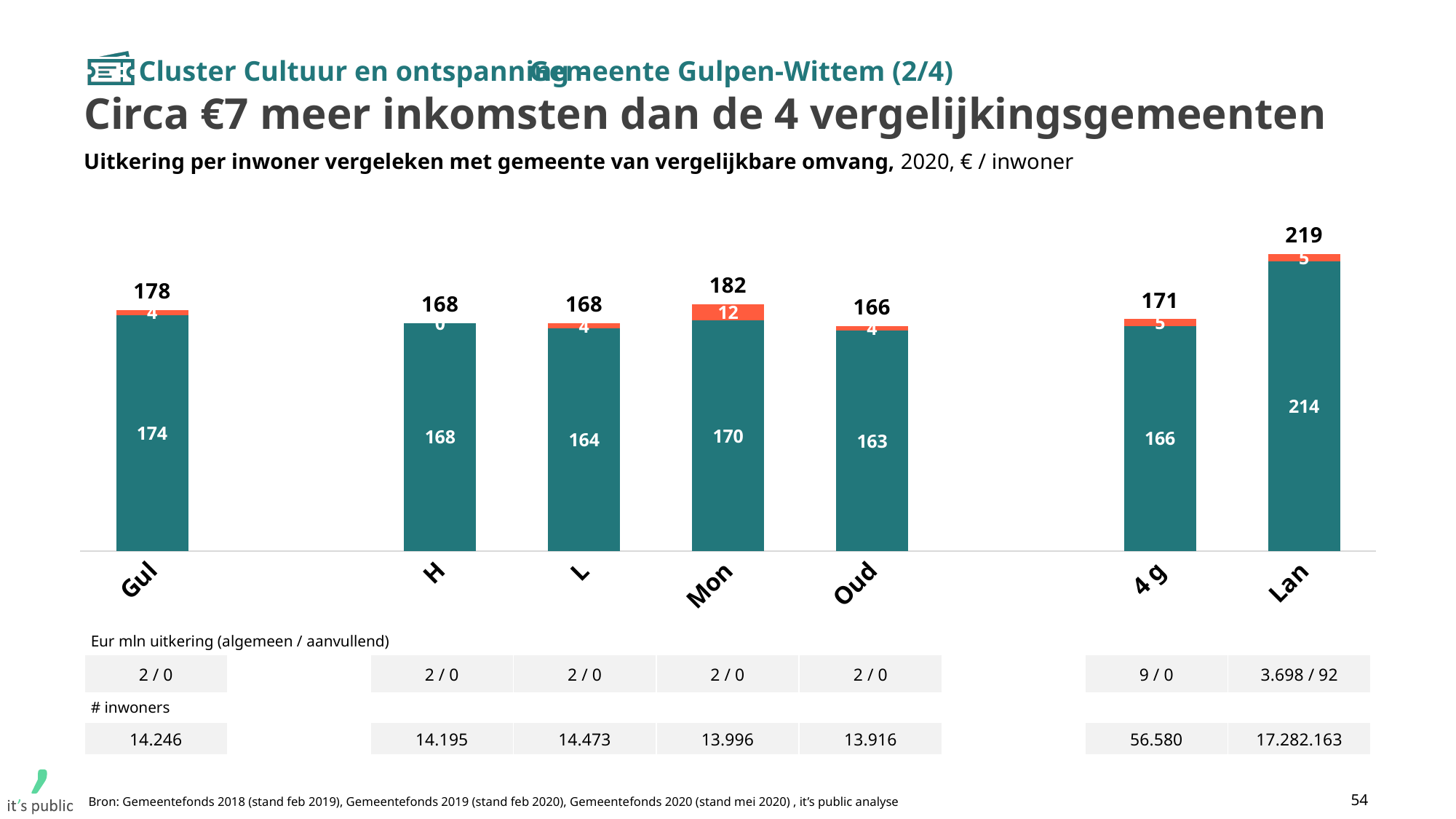
What is the total value shown above the bar for Gul? 178 What is the difference between the total for Gul and the total for 4 g? 7 What is the value of the orange (upper) segment for H? 0 What type of chart is shown on the slide? Stacked bar chart What is the value of the teal (lower) segment for Oud? 163 Which category has the highest total value? Lan What is the value of the teal (lower) segment for Lan? 214 How many bars are shown in the chart? 7 Which category has the lowest total value? Oud What is the value of the orange (upper) segment for Mon? 12 What is the total of the stacked bar for Mon (170 + 12)? 182 Which has a larger total, Mon or H? Mon